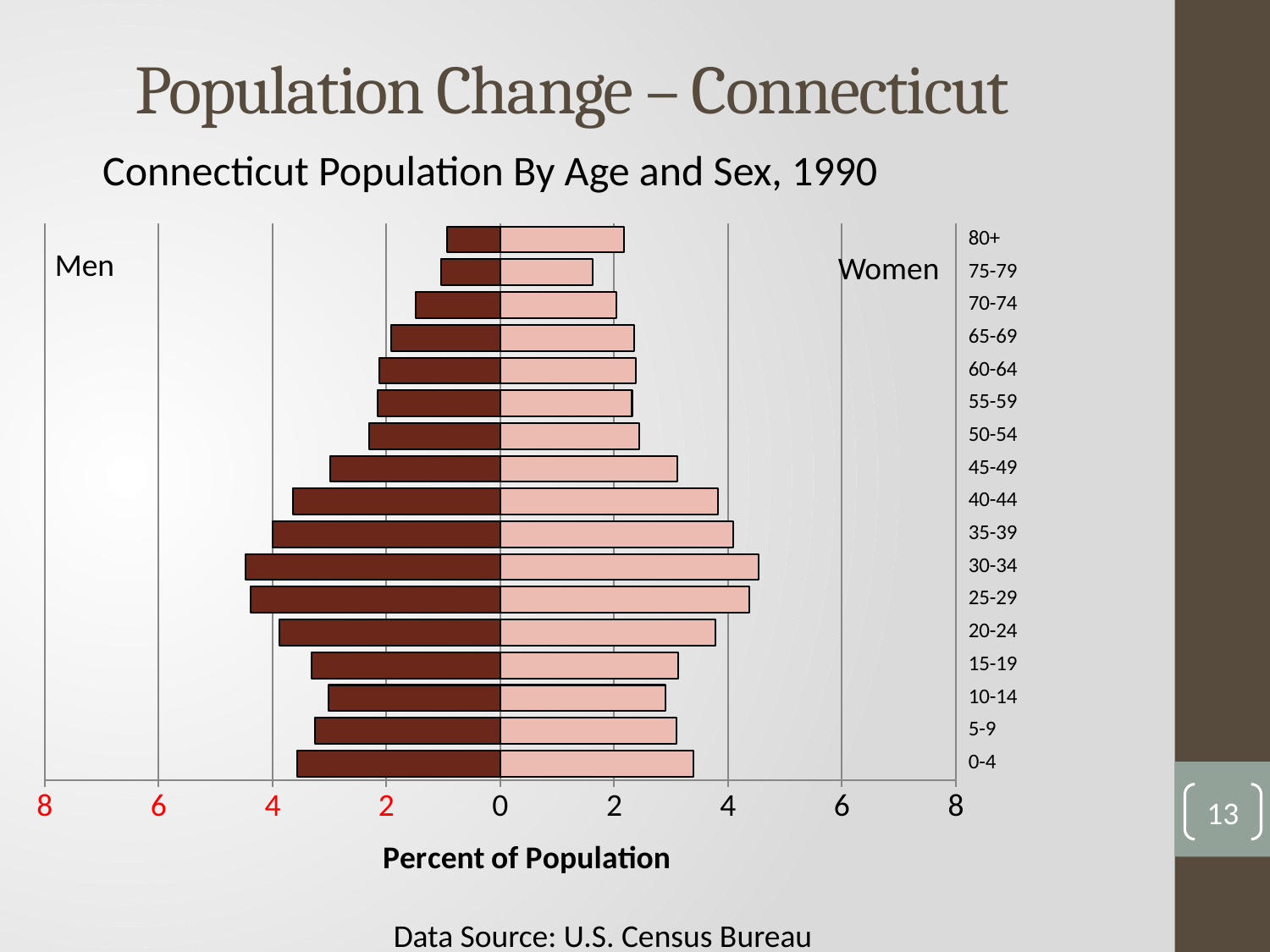
For Men, which is larger, the value for ages 30-34 or the value for ages 60-64? 30-34 Is the value for Men aged 30-34 greater or less than 4? greater Is the value for Women aged 80+ greater or less than 2? greater Which age group has the longest bar for Men? 30-34 Which age group has the shortest bar for Women? 75-79 For the 80+ age group, which is larger, the value for Men or the value for Women? Women How many age groups are shown on the chart? 17 Is the value for Men aged 80+ greater or less than 2? less What is the title of the chart? Connecticut Population By Age and Sex, 1990 What is the label on the horizontal axis of the chart? Percent of Population What kind of chart is shown on the slide? bar chart